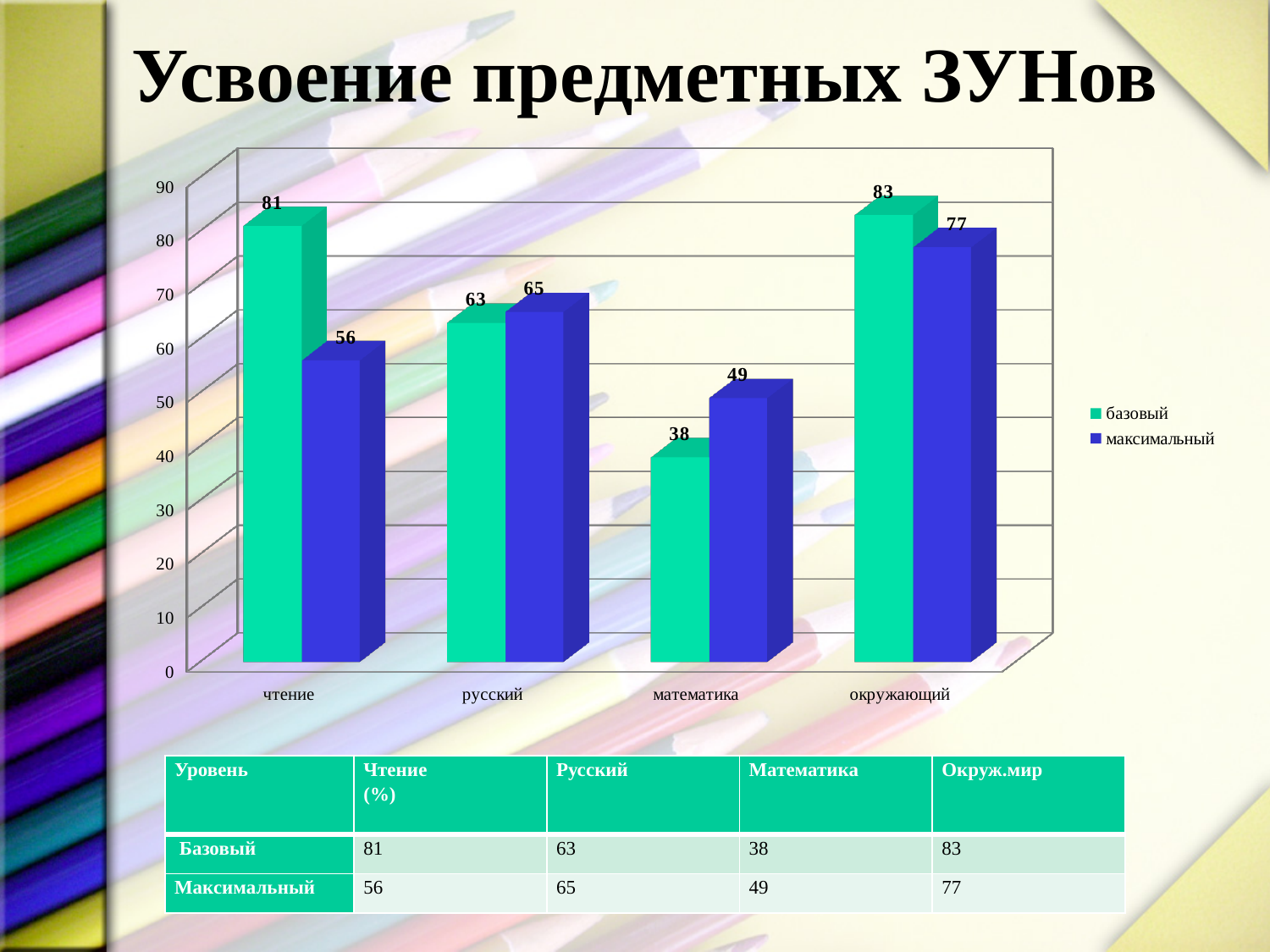
Which is larger for русский: the базовый value or the максимальный value? максимальный What is the value of the максимальный series for математика? 49 Is the базовый value for математика greater or less than 40? less Which category has the lowest максимальный value? математика How many categories are shown on the x axis? 4 What is the title of the slide? Усвоение предметных ЗУНов How many series does the legend list? 2 What is the value of the максимальный series for окружающий? 77 What kind of chart is shown on the slide? bar chart What is the difference between the базовый and максимальный values for чтение? 25 What is the value of the базовый series for чтение? 81 Which category has the highest базовый value? окружающий